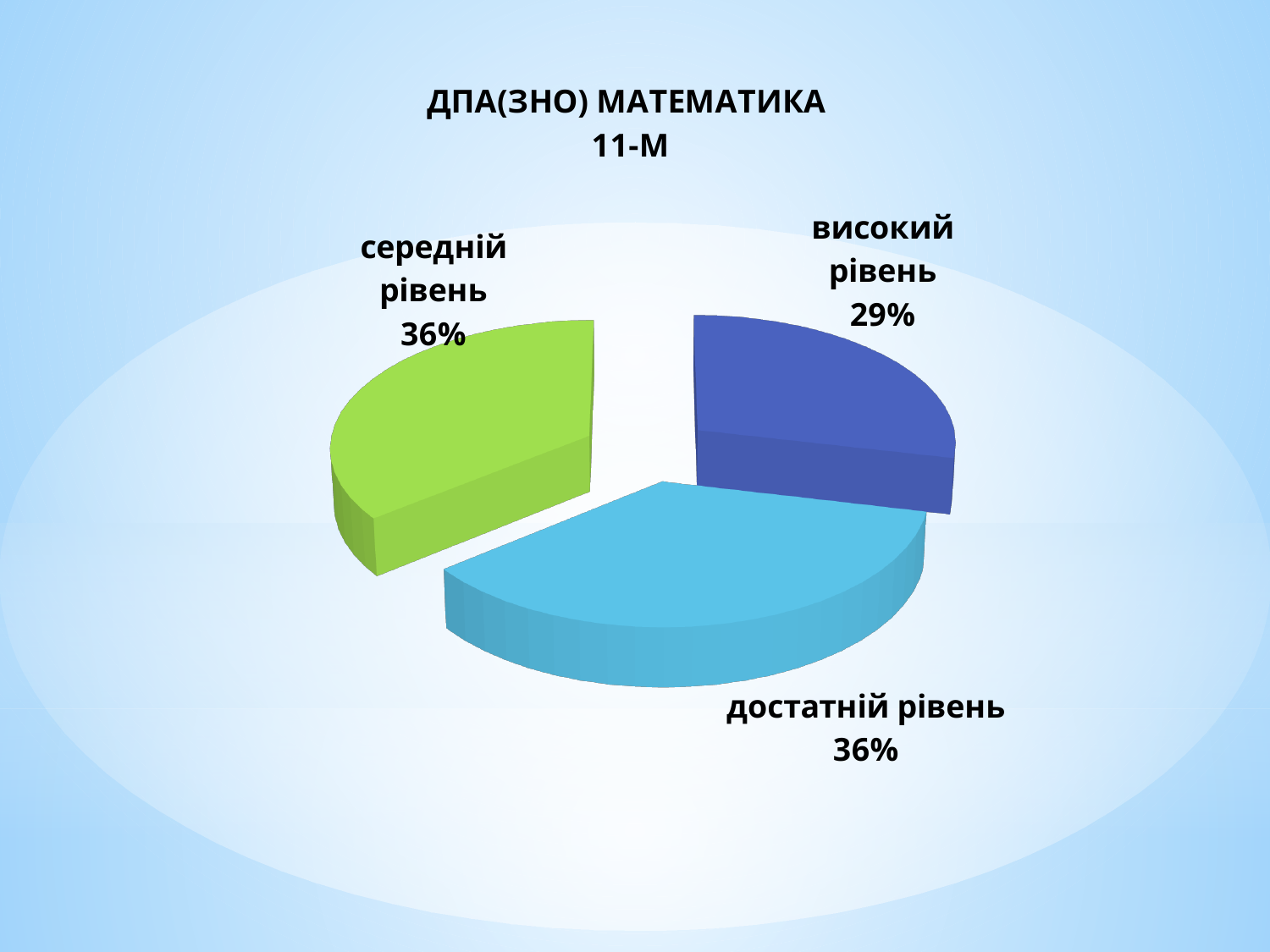
What share of the pie does високий рівень have? 29% What colour is the slice for середній рівень? green What share of the pie does достатній рівень have? 36% How many slices does the pie chart have? 3 Which category has the smallest slice of the pie? високий рівень What is the difference in percentage points between достатній рівень and високий рівень? 7 Which is larger: the slice for високий рівень or the slice for середній рівень? середній рівень What is the difference in percentage points between середній рівень and високий рівень? 7 Which is larger: the slice for достатній рівень or the slice for високий рівень? достатній рівень What is the title of the chart? ДПА(ЗНО) МАТЕМАТИКА 11-М What kind of chart is shown on the slide? pie chart What share of the pie does середній рівень have? 36%